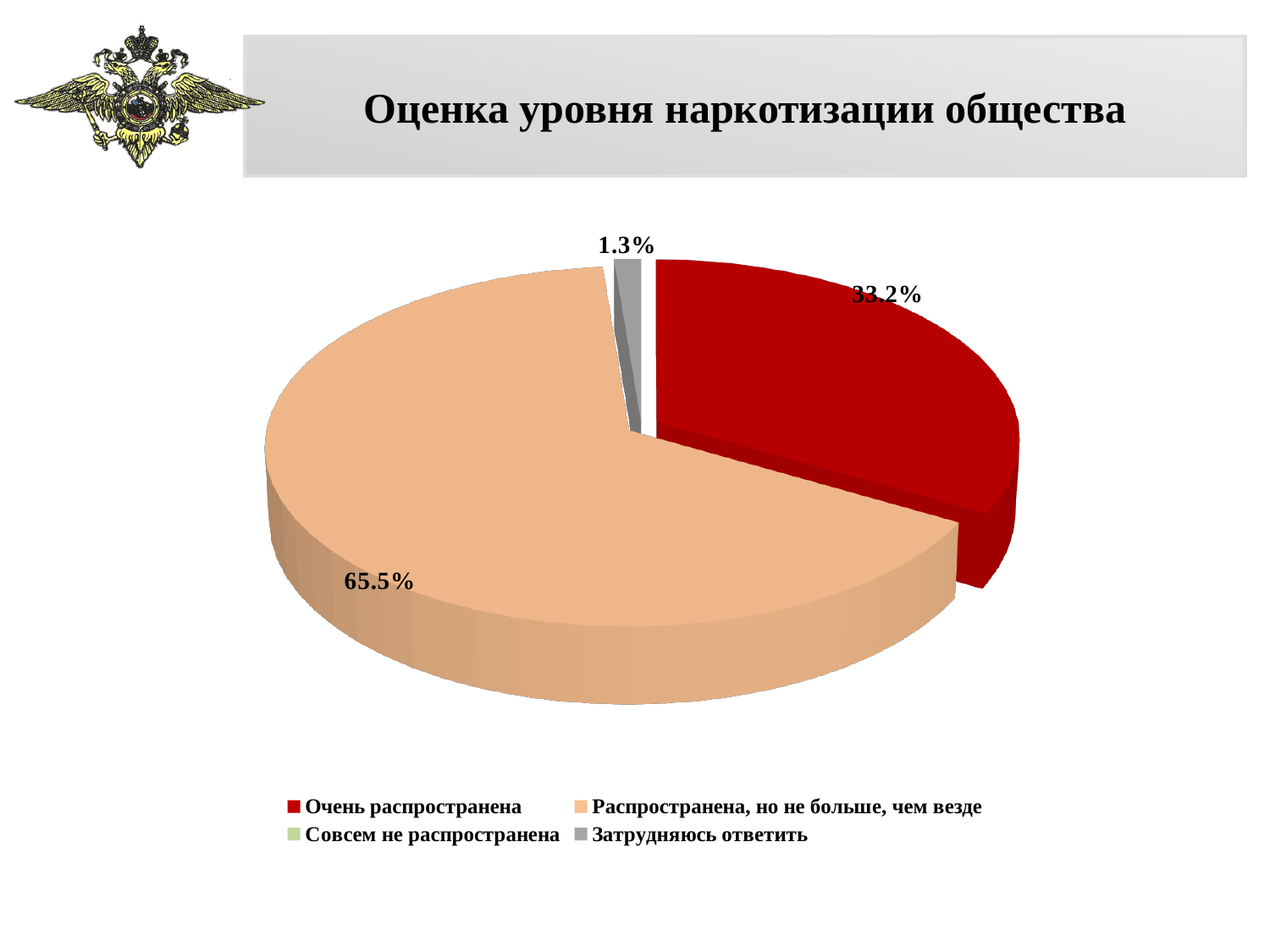
Which labelled slice has the smallest share of the pie? Затрудняюсь ответить What type of chart is shown on the slide? Pie chart What percentage is shown for "Затрудняюсь ответить"? 1.3% What is the difference in percentage points between "Распространена, но не больше, чем везде" and "Очень распространена"? 32.3 Which is larger: the share for "Очень распространена" or the share for "Затрудняюсь ответить"? Очень распространена What percentage is shown for "Очень распространена"? 33.2% Which category has the largest share of the pie? Распространена, но не больше, чем везде How many entries does the legend list? 4 Is the share for "Очень распространена" greater or less than 50%? less What percentage is shown for "Распространена, но не больше, чем везде"? 65.5% What is the title of the chart? Оценка уровня наркотизации общества What colour is the slice for "Очень распространена"? Red